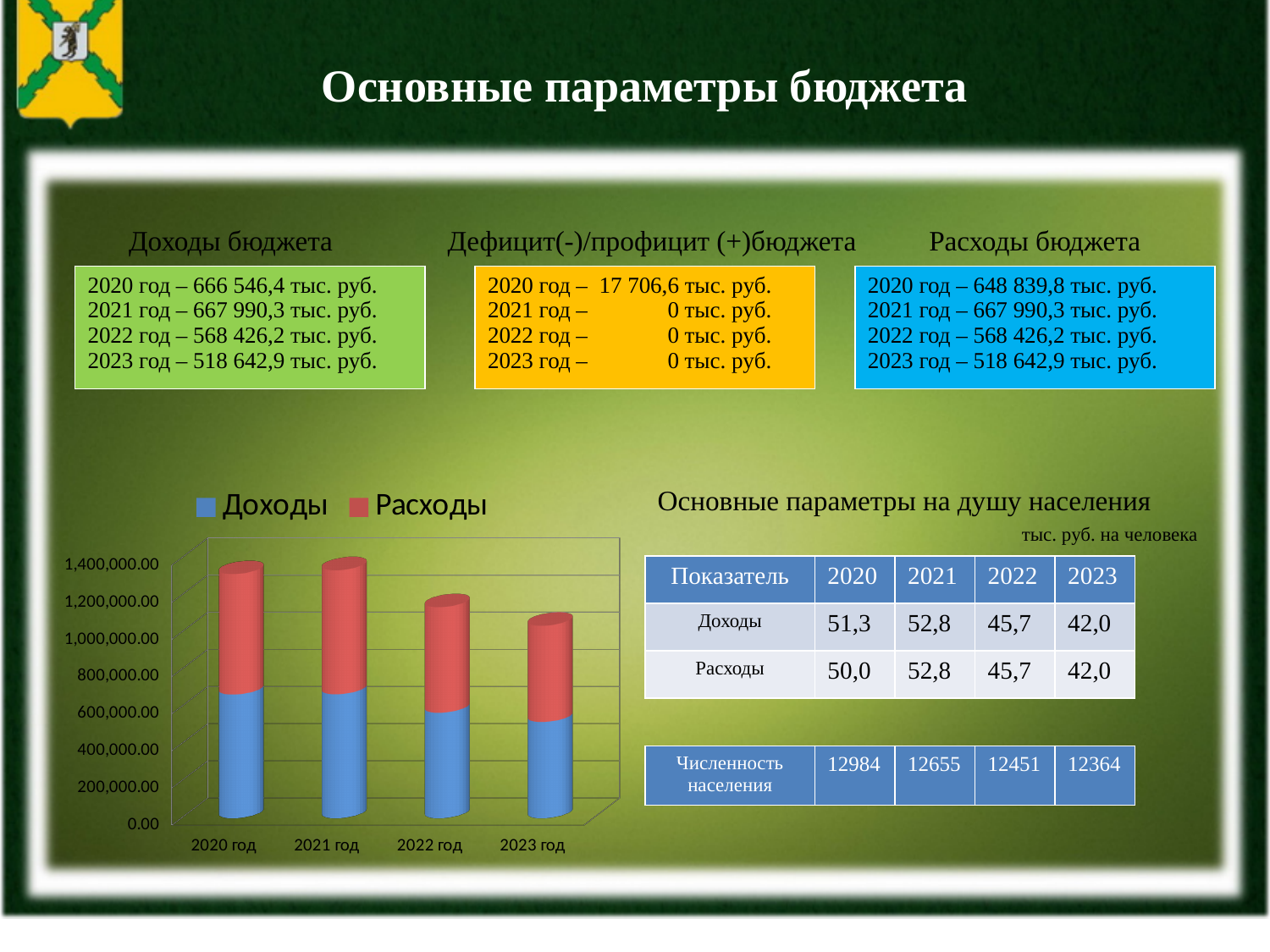
What kind of chart is shown on the slide? bar chart How many series does the chart legend list? 2 Which year has the lowest total stacked bar in the chart? 2023 год Which series is shown in blue in the chart? Доходы How many year categories are shown on the x axis of the chart? 4 Is the total stacked bar for 2020 год greater or less than 1,200,000.00? greater Is the Доходы value for 2020 год greater or less than 600,000.00? greater Is the total stacked bar for 2022 год greater or less than 1,000,000.00? greater Which total stacked bar is larger, 2022 год or 2023 год? 2022 год Do the total stacked bars rise or fall from 2021 год to 2023 год? fall Which series is shown in red in the chart? Расходы